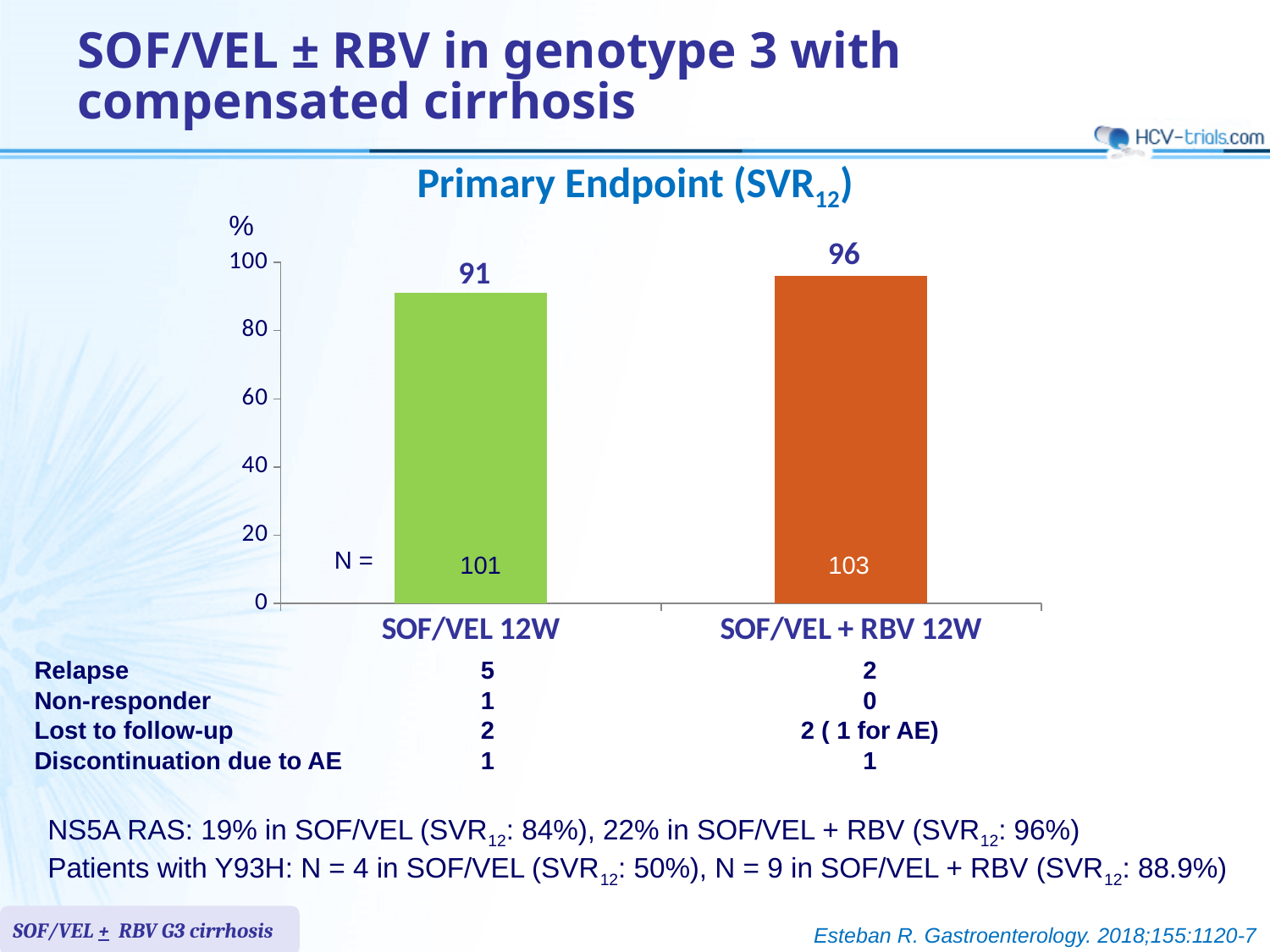
Which treatment arm has the higher SVR12 rate? SOF/VEL + RBV 12W What is the N for the SOF/VEL + RBV 12W arm? 103 How many treatment arms are shown in the chart? 2 What is the SVR12 value for SOF/VEL 12W? 91 What colour is the bar for SOF/VEL + RBV 12W? orange What is the title of the chart? Primary Endpoint (SVR12) What kind of chart is shown on the slide? bar chart What is the N for the SOF/VEL 12W arm? 101 Which treatment arm has the lower SVR12 rate? SOF/VEL 12W Is the SVR12 value for SOF/VEL 12W greater or less than 80? greater What is the SVR12 value for SOF/VEL + RBV 12W? 96 What is the difference in SVR12 between SOF/VEL + RBV 12W and SOF/VEL 12W? 5